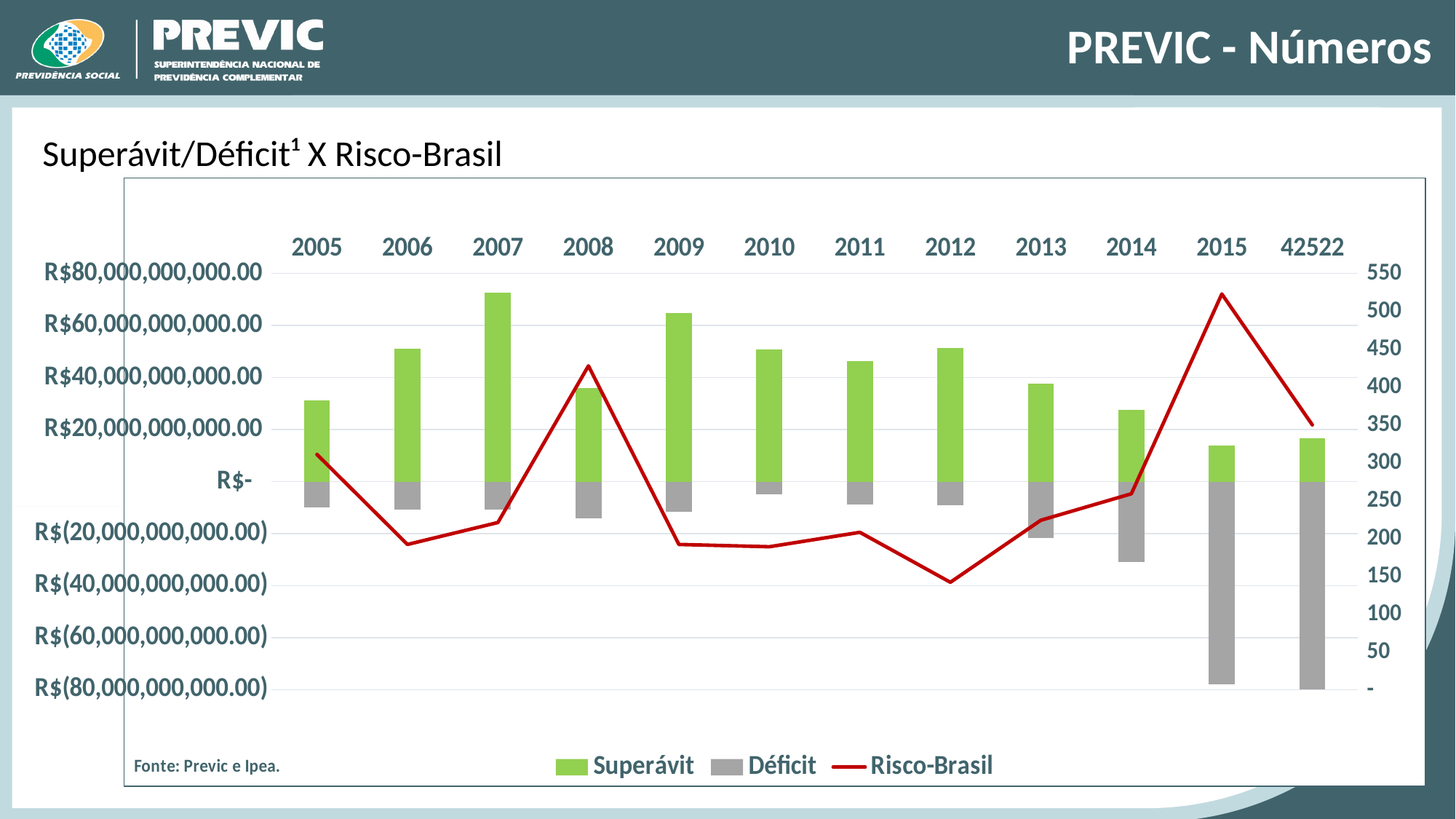
In which year does the Risco-Brasil line reach its highest point? 2015 How many series does the chart's legend list? 3 In which year is the Superávit bar the highest? 2007 In which year does the Risco-Brasil line reach its lowest point? 2012 Is the Risco-Brasil value for 2008 greater or less than 400? greater What source is cited at the bottom of the chart? Fonte: Previc e Ipea. Is the Superávit value for 2007 greater or less than R$60,000,000,000.00? greater Does the Risco-Brasil line rise or fall from 2012 to 2015? It rises Which year has the larger Superávit bar, 2009 or 2011? 2009 How many categories are shown along the x axis of the chart? 12 Is the Superávit value for 2005 greater or less than R$40,000,000,000.00? less What kind of chart is shown on the slide? A combined bar and line chart